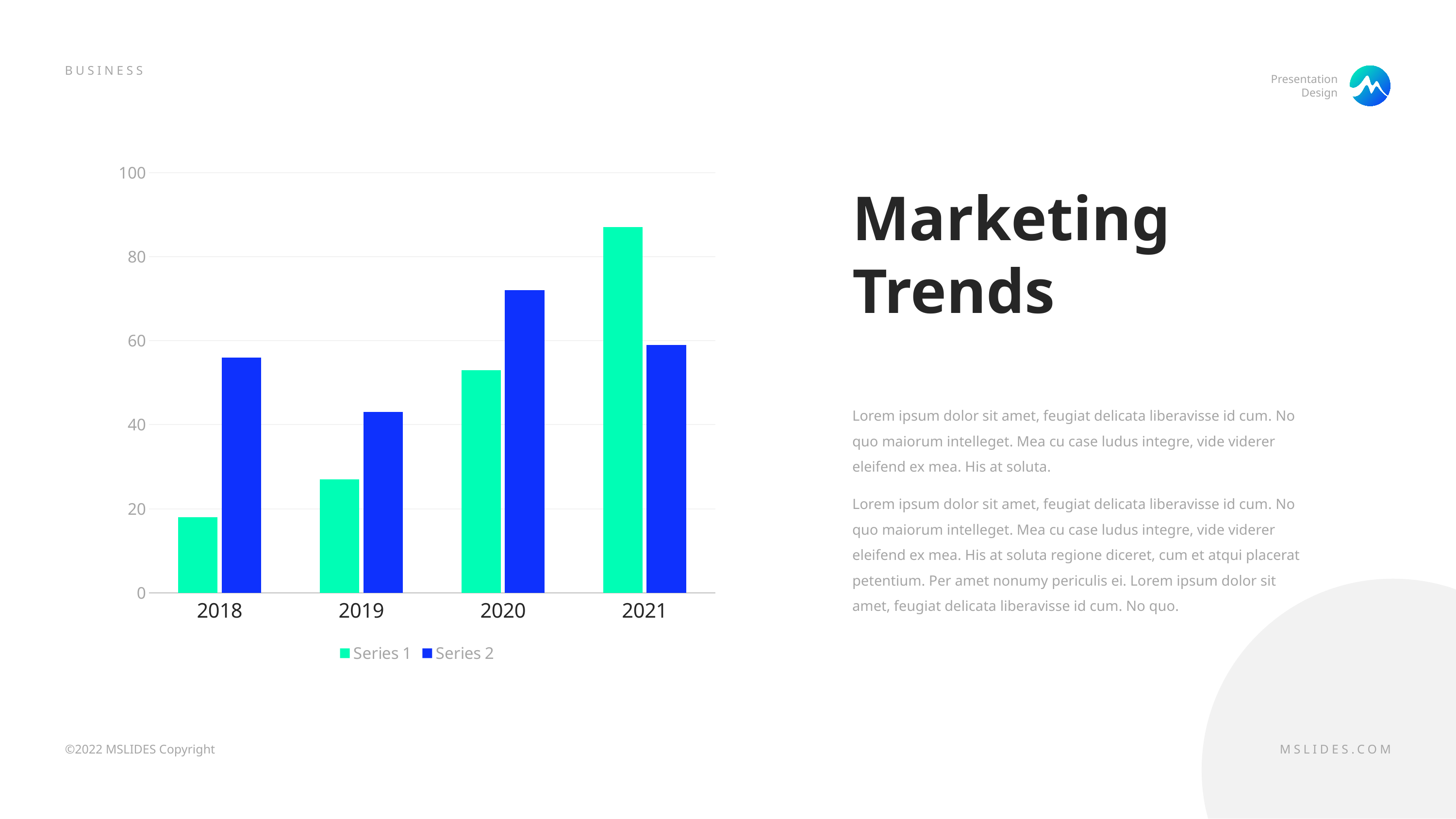
Is the value for Series 2 in 2020 greater or less than 60? greater How many years are shown on the x axis of the chart? 4 Which year has the lowest value for Series 2? 2019 Which year has the highest value for Series 2? 2020 Which year has the lowest value for Series 1? 2018 Is the value for Series 1 in 2021 greater or less than 80? greater Which year has the highest value for Series 1? 2021 Do the Series 1 values rise or fall from 2018 to 2021? rise How many series does the chart legend list? 2 In 2021, which series has the larger value, Series 1 or Series 2? Series 1 What kind of chart is shown on the slide? bar chart In 2018, which series has the larger value, Series 1 or Series 2? Series 2